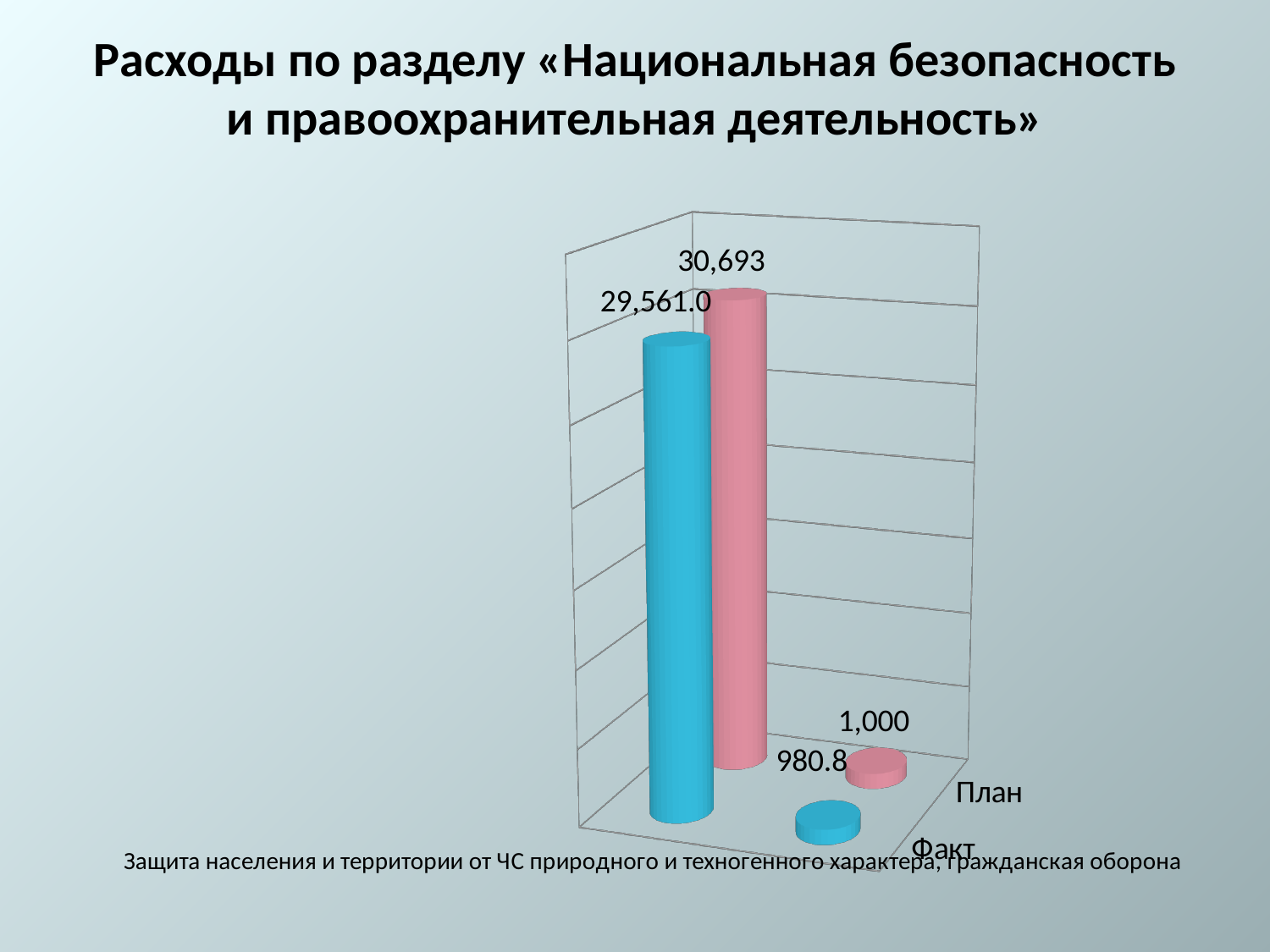
What is the value of the tallest blue (Факт) bar? 29,561.0 Which bar has the highest value on the chart? План, 30,693 Which colour represents the Факт series? Blue What is the value of the tallest pink (План) bar? 30,693 What is the difference between the smaller План value (1,000) and the smaller Факт value (980.8)? 19.2 What type of chart is shown on the slide? Bar chart Which bar has the lowest value on the chart? Факт, 980.8 What is the difference between the larger План value (30,693) and the larger Факт value (29,561.0)? 1,132 For the taller pair of bars, which is larger: План or Факт? План What is the value of the smaller pink (План) bar? 1,000 What is the value of the smaller blue (Факт) bar? 980.8 How many series are shown on the chart? 2